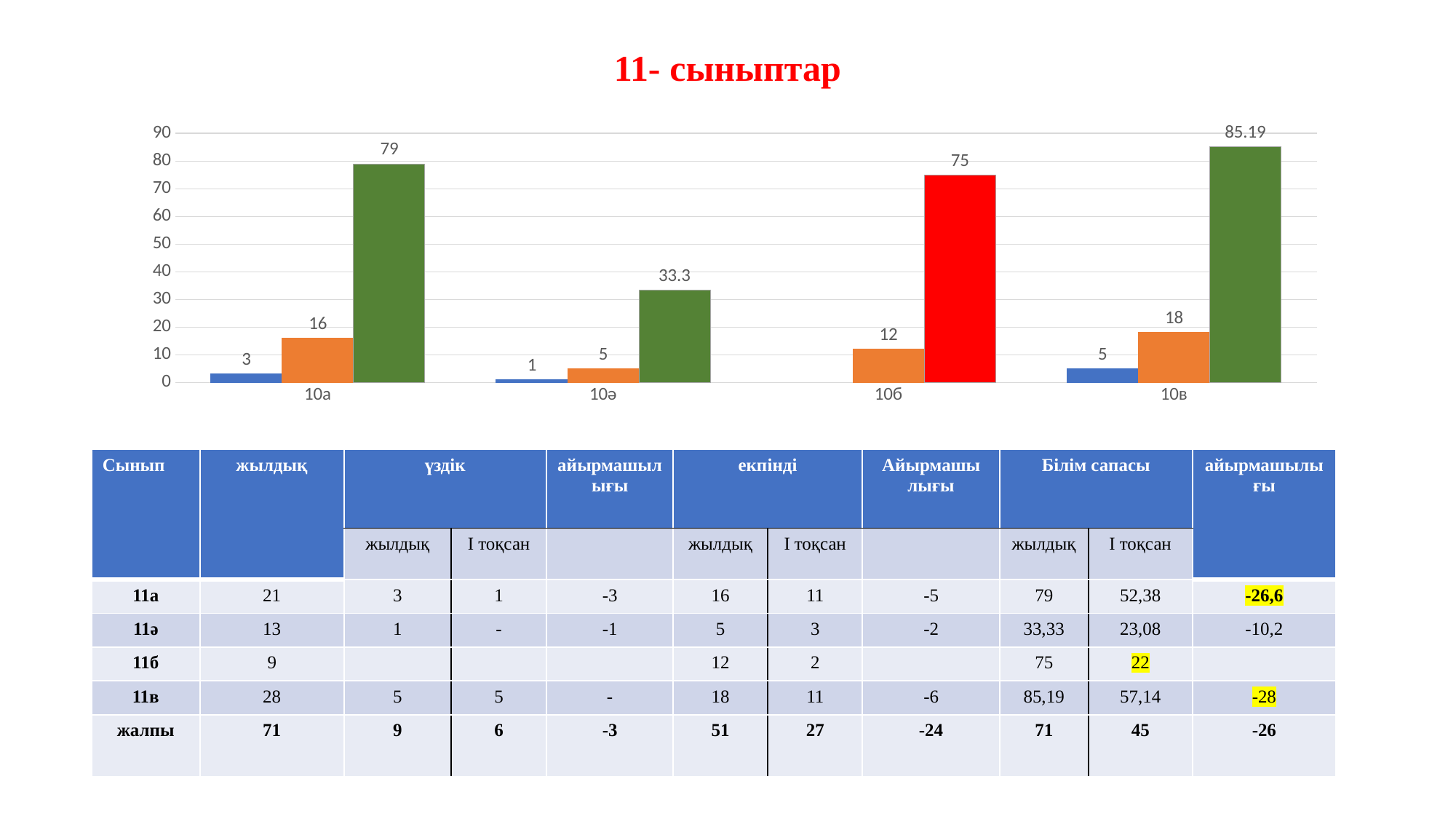
What is the value of the blue bar for 10ә? 1 What is the difference between the orange bars for 10в and 10а? 2 What is the title of the slide? 11- сыныптар What is the value of the green bar for 10а? 79 Is the tallest bar for 10ә greater or less than 40? less How many categories are shown on the x axis of the chart? 4 Which is larger, the green bar for 10а or the red bar for 10б? 10а Which category has the tallest bar in the chart? 10в What is the value of the red bar for 10б? 75 What kind of chart is shown on the slide? bar chart Which category has the lowest orange bar? 10ә What is the value of the orange bar for 10в? 18